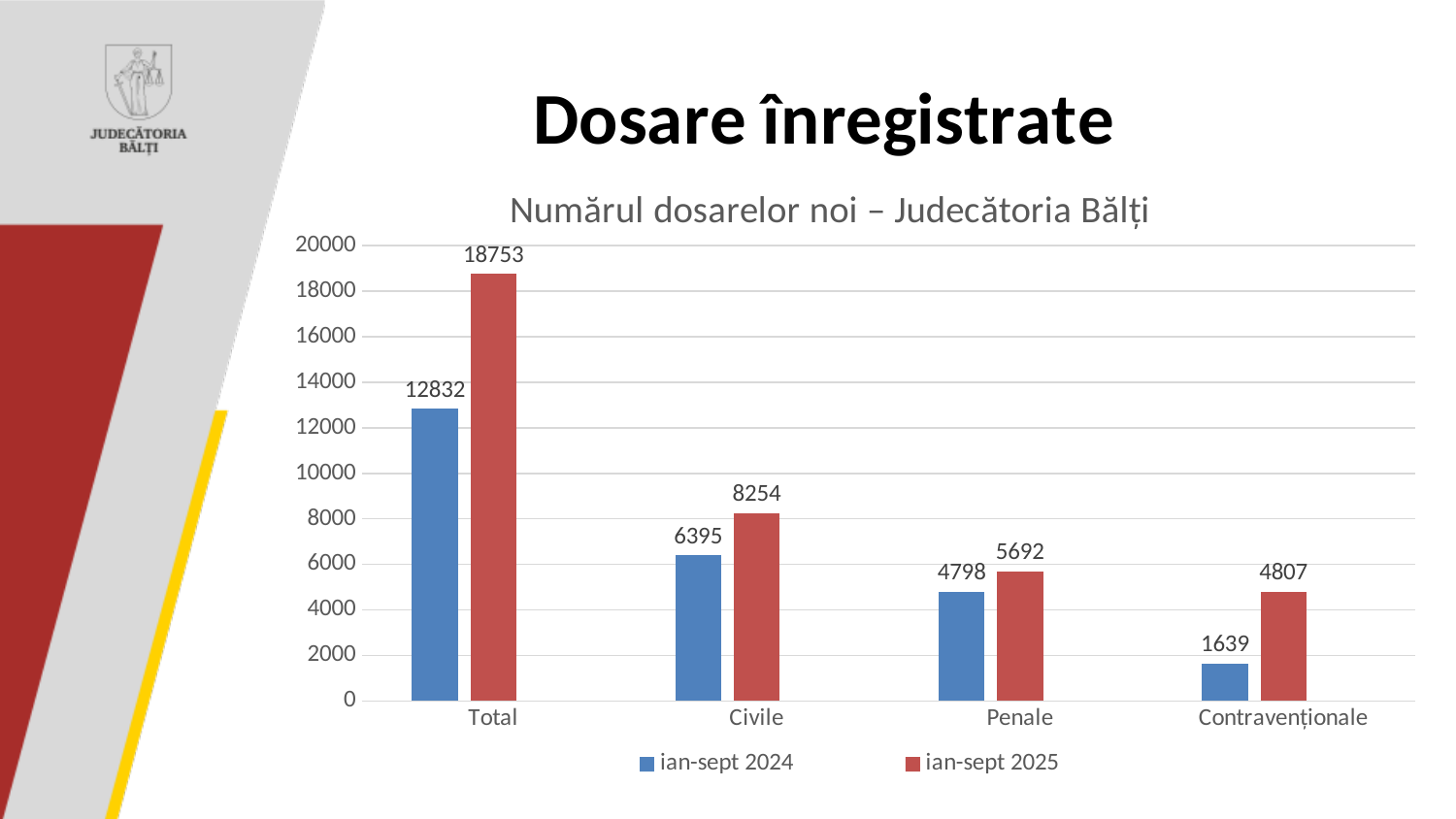
How many categories are shown on the x axis? 4 How many series does the legend list? 2 Which category has the lowest value in the ian-sept 2024 series? Contravenționale What is the difference between the ian-sept 2025 and ian-sept 2024 values for Contravenționale? 3168 What is the value for Penale in the ian-sept 2025 series? 5692 What kind of chart is shown on the slide? Bar chart What is the value for Civile in the ian-sept 2025 series? 8254 What is the title of the chart? Numărul dosarelor noi – Judecătoria Bălți What is the value for Contravenționale in the ian-sept 2024 series? 1639 Which is larger for Penale: the ian-sept 2024 value or the ian-sept 2025 value? ian-sept 2025 Which category has the highest value in the ian-sept 2025 series? Total What is the difference between the ian-sept 2025 and ian-sept 2024 values for Total? 5921